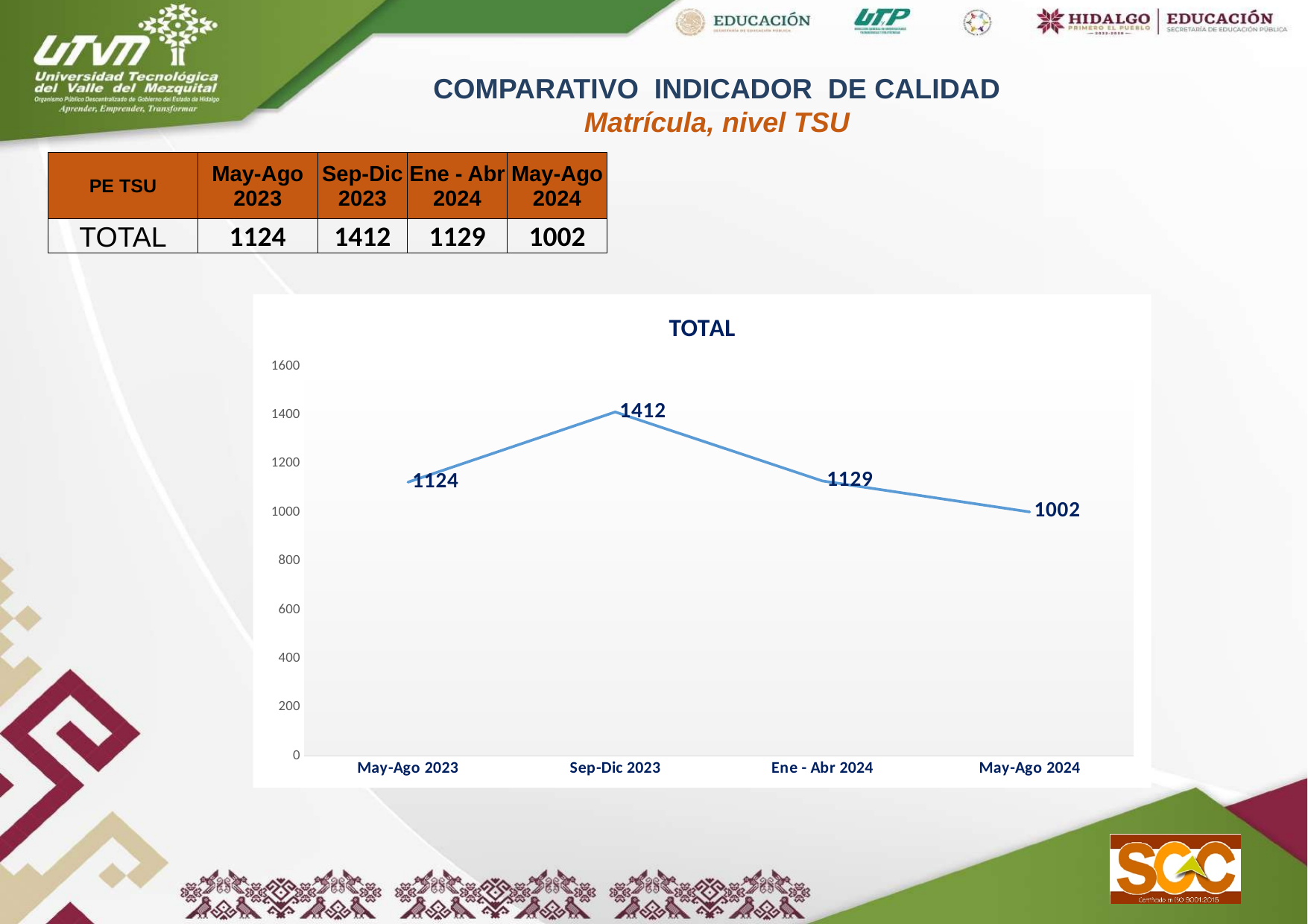
Is the value for Sep-Dic 2023 greater or less than 1200? greater What is the value for Ene - Abr 2024? 1129 What is the title of the chart? TOTAL What is the value for May-Ago 2024? 1002 Which period has the lowest value? May-Ago 2024 What is the difference between the values for May-Ago 2023 and Ene - Abr 2024? 5 Which period has the highest value? Sep-Dic 2023 What kind of chart is shown? line chart What is the value for Sep-Dic 2023? 1412 How many periods are plotted on the x axis? 4 Which is larger, the value for May-Ago 2023 or the value for May-Ago 2024? May-Ago 2023 What is the difference between the values for Sep-Dic 2023 and May-Ago 2024? 410